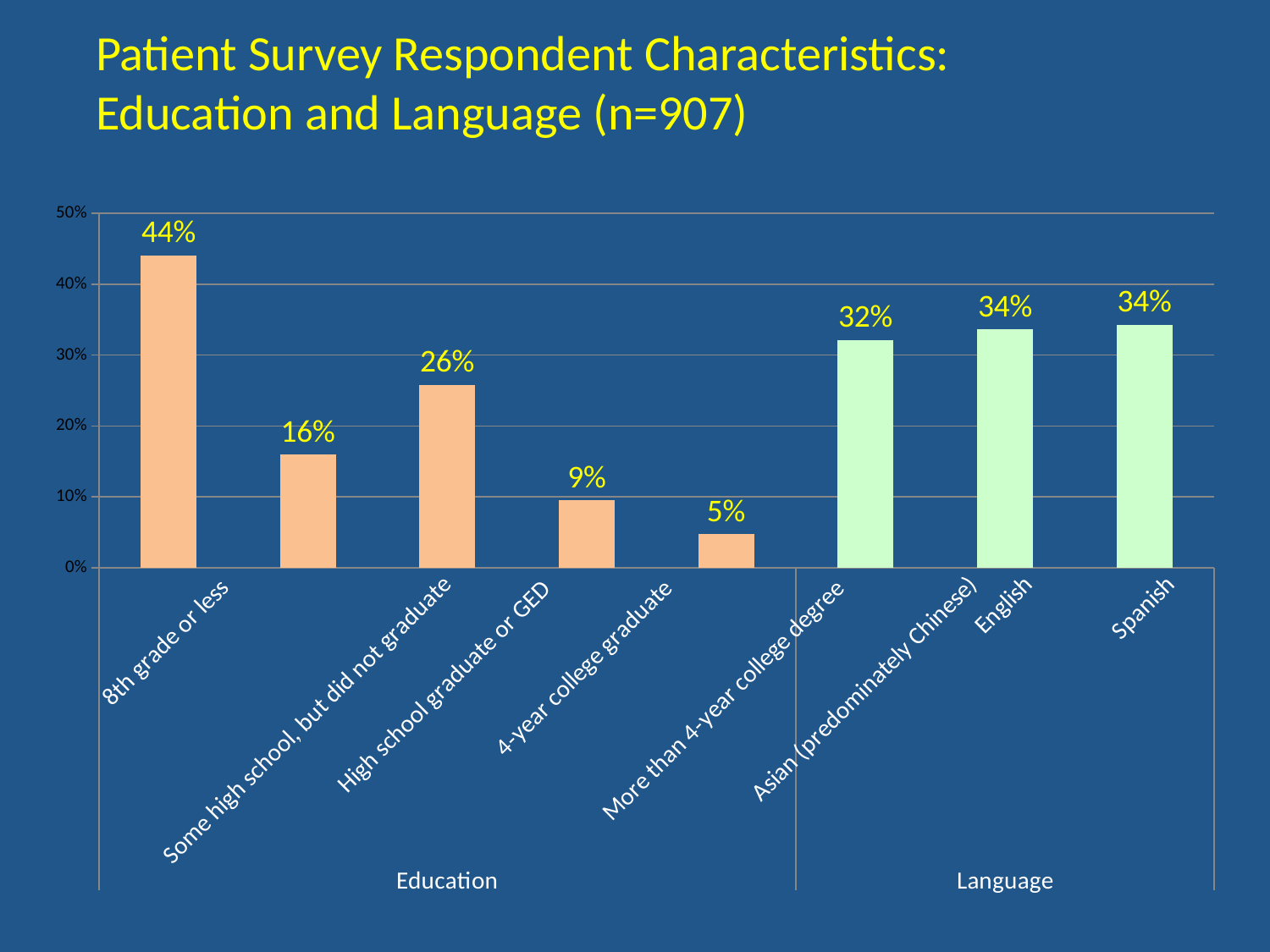
What is the difference in percentage points between respondents with 8th grade or less and those with some high school but did not graduate? 28 What are the two group labels shown beneath the x axis of the chart? Education and Language Which education category has the lowest percentage of respondents? More than 4-year college degree What percentage of respondents speak Spanish? 34% How many education categories are shown in the chart? 5 What percentage of respondents are high school graduates or have a GED? 26% Which education category has the highest percentage of respondents? 8th grade or less What kind of chart is shown on the slide? Bar chart Is the value for 4-year college graduate greater or less than 10%? less Which is larger: the percentage of respondents who speak Asian (predominately Chinese) or the percentage who speak English? English What percentage of respondents have an education level of 8th grade or less? 44% What percentage of respondents have more than a 4-year college degree? 5%